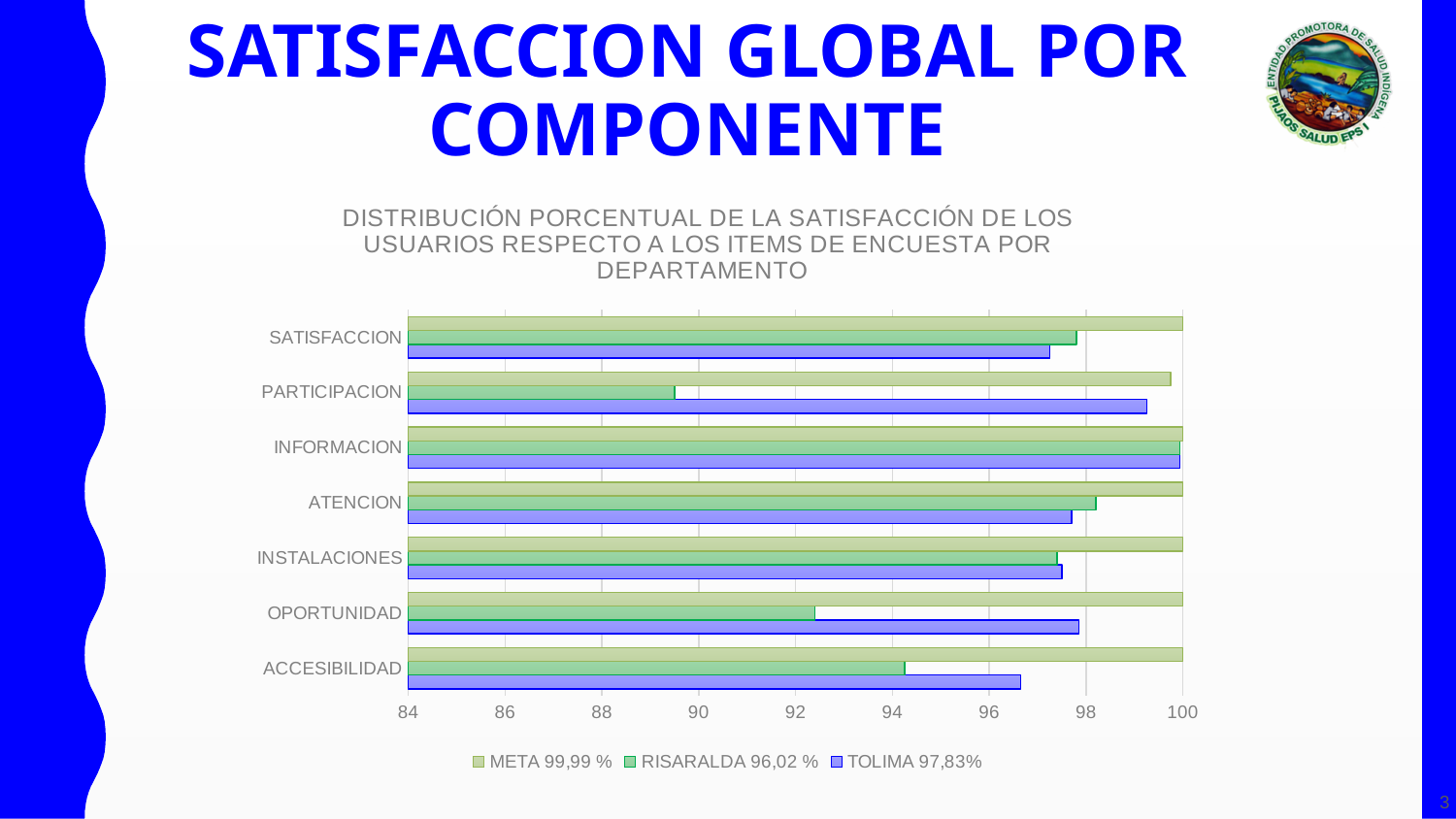
How many series does the chart legend list? 3 Is the RISARALDA value for OPORTUNIDAD greater or less than 94? less Is the RISARALDA value for PARTICIPACION greater or less than 90? less Is the TOLIMA value for PARTICIPACION greater or less than 98? greater Which legend entry is shown with the purple/blue bars? TOLIMA 97,83% What kind of chart is shown on the slide? bar chart What is the title of the chart? DISTRIBUCIÓN PORCENTUAL DE LA SATISFACCIÓN DE LOS USUARIOS RESPECTO A LOS ITEMS DE ENCUESTA POR DEPARTAMENTO How many categories are plotted on the vertical axis of the chart? 7 For PARTICIPACION, which is larger: the RISARALDA value or the TOLIMA value? TOLIMA Which category has the lowest RISARALDA value? PARTICIPACION Which category has the lowest TOLIMA value? ACCESIBILIDAD